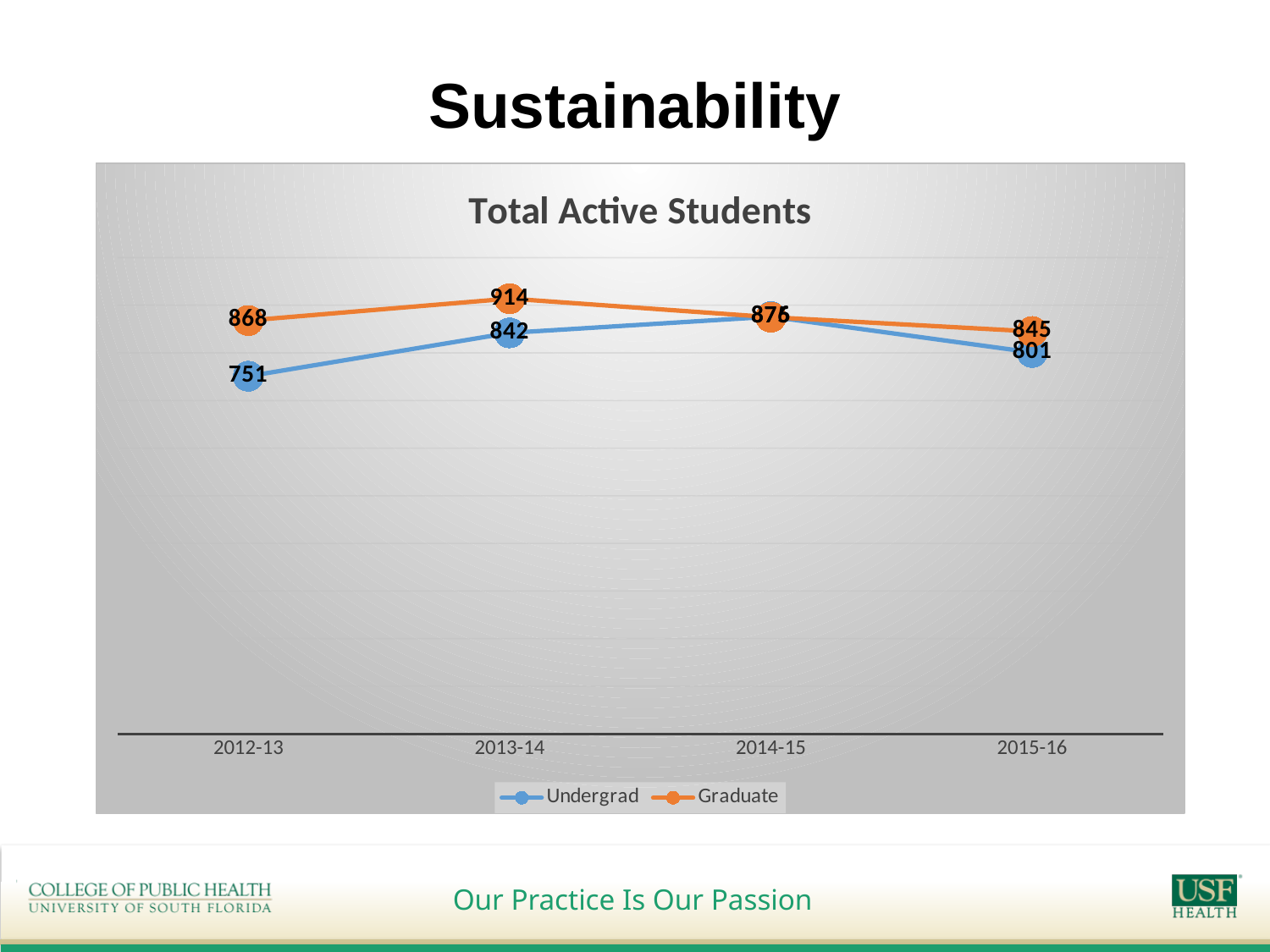
What kind of chart is shown on the slide? Line chart How many academic years are shown on the x axis? 4 What is the difference between the Graduate and Undergrad values in 2012-13? 117 What is the Undergrad value for 2015-16? 801 What is the Undergrad value for 2012-13? 751 In 2015-16, which series has the larger value, Undergrad or Graduate? Graduate By how much did the Undergrad value increase from 2012-13 to 2013-14? 91 In which year is the Graduate series highest? 2013-14 What is the Graduate value for 2013-14? 914 In which year is the Undergrad series lowest? 2012-13 What is the Graduate value for 2015-16? 845 How many series does the legend list? 2